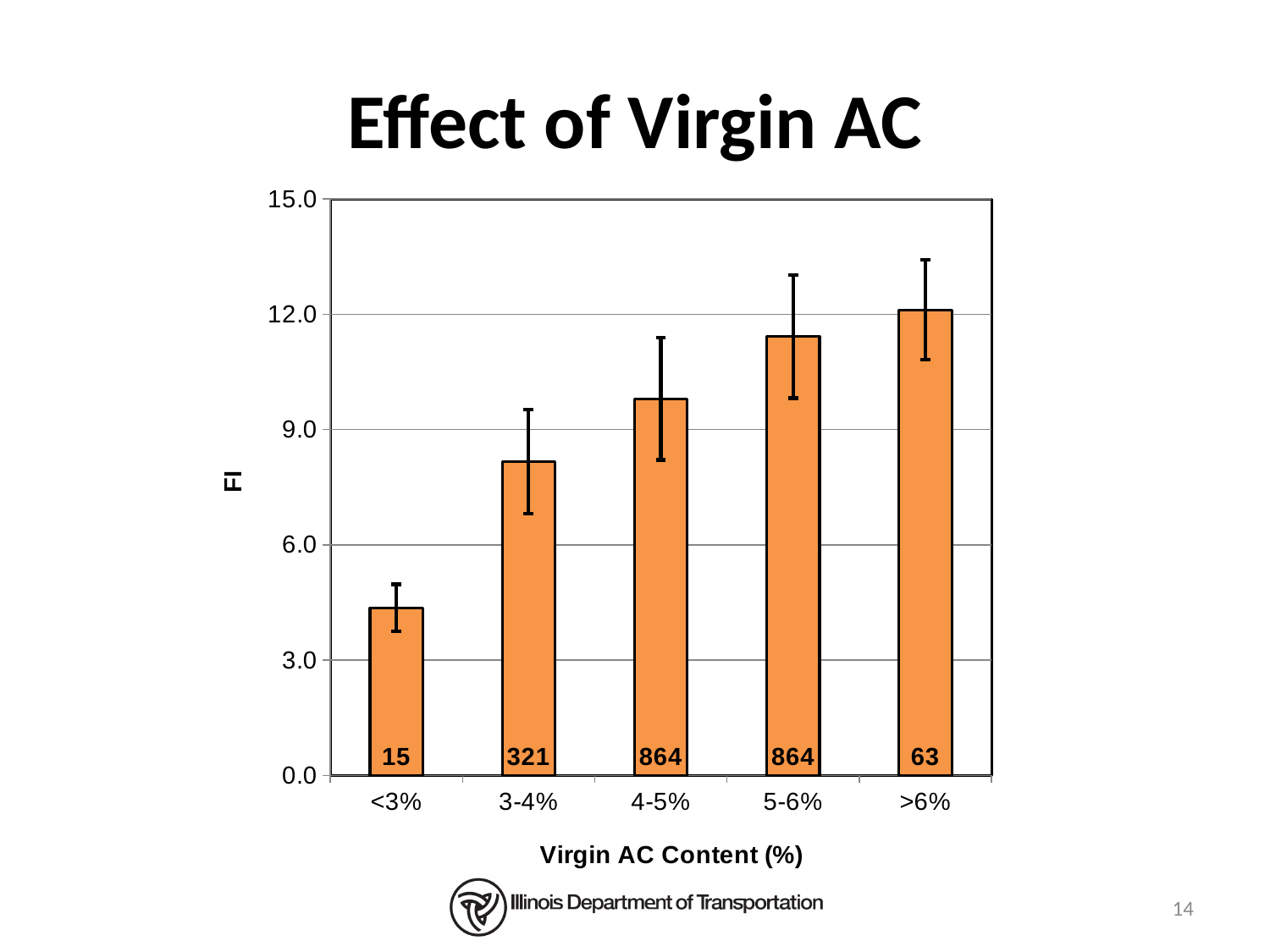
What number is printed inside the bar for the 3-4% category? 321 Which Virgin AC Content category has the lowest FI? <3% Do the FI values rise or fall as Virgin AC Content increases along the x axis? rise Is the FI value for 3-4% greater or less than 6.0? greater Which Virgin AC Content category has the highest FI? >6% Is the FI value for <3% greater or less than 6.0? less How many Virgin AC Content categories are plotted on the x axis? 5 Which has a higher FI, 3-4% or 5-6%? 5-6% What kind of chart is shown on the slide? Bar chart Is the FI value for 5-6% greater or less than 12.0? less What is the title of the chart? Effect of Virgin AC